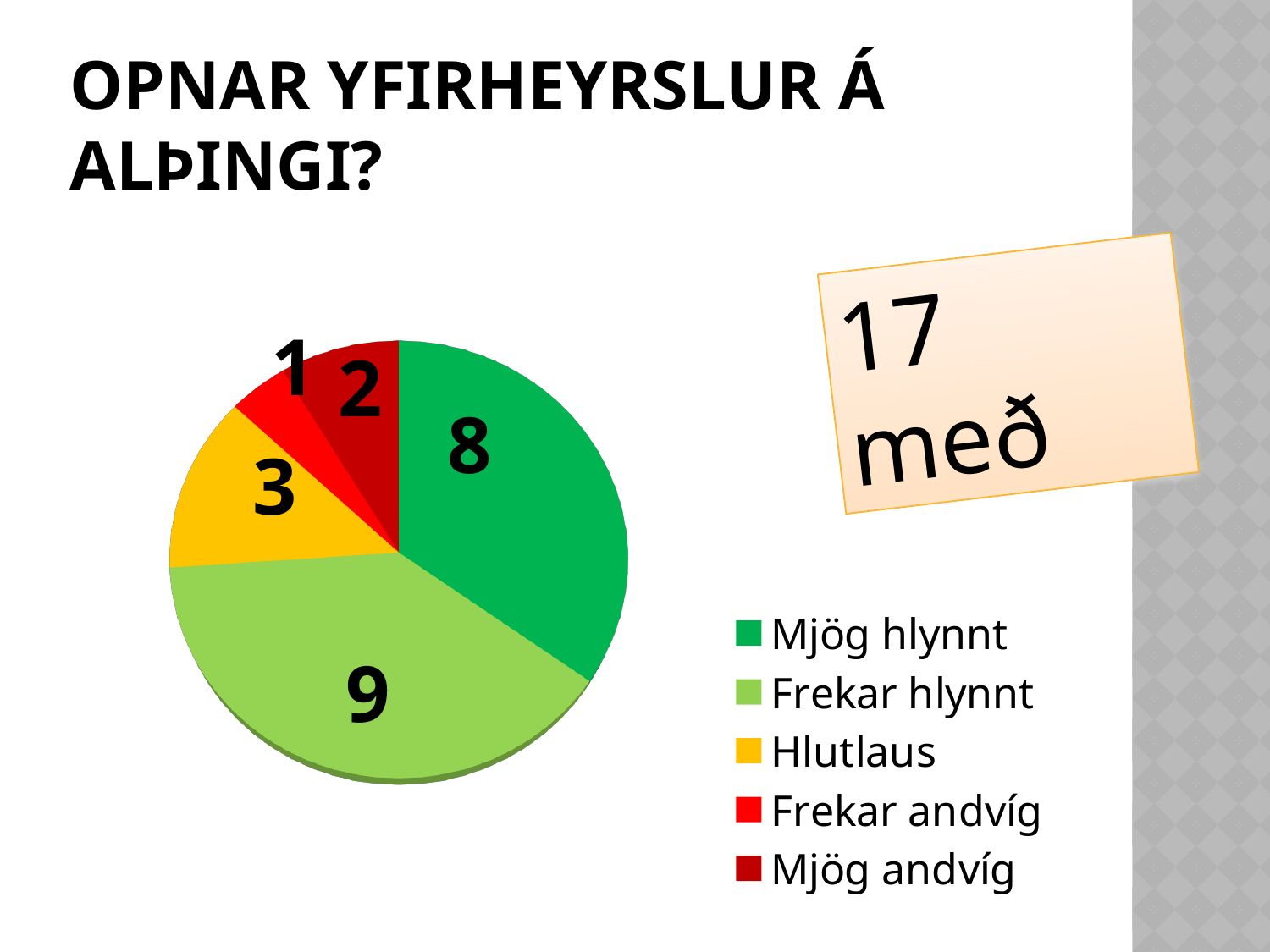
How many categories does the legend list? 5 What colour is the Hlutlaus slice? yellow What is the value for Hlutlaus? 3 Which is larger, the value for Mjög hlynnt or the value for Mjög andvíg? Mjög hlynnt What is the difference between the values for Frekar hlynnt and Hlutlaus? 6 Which category has the largest slice? Frekar hlynnt What is the value for Frekar hlynnt? 9 What is the value for Mjög hlynnt? 8 What is the value for Frekar andvíg? 1 What is the value for Mjög andvíg? 2 What kind of chart is shown on the slide? pie chart Which category has the smallest slice? Frekar andvíg